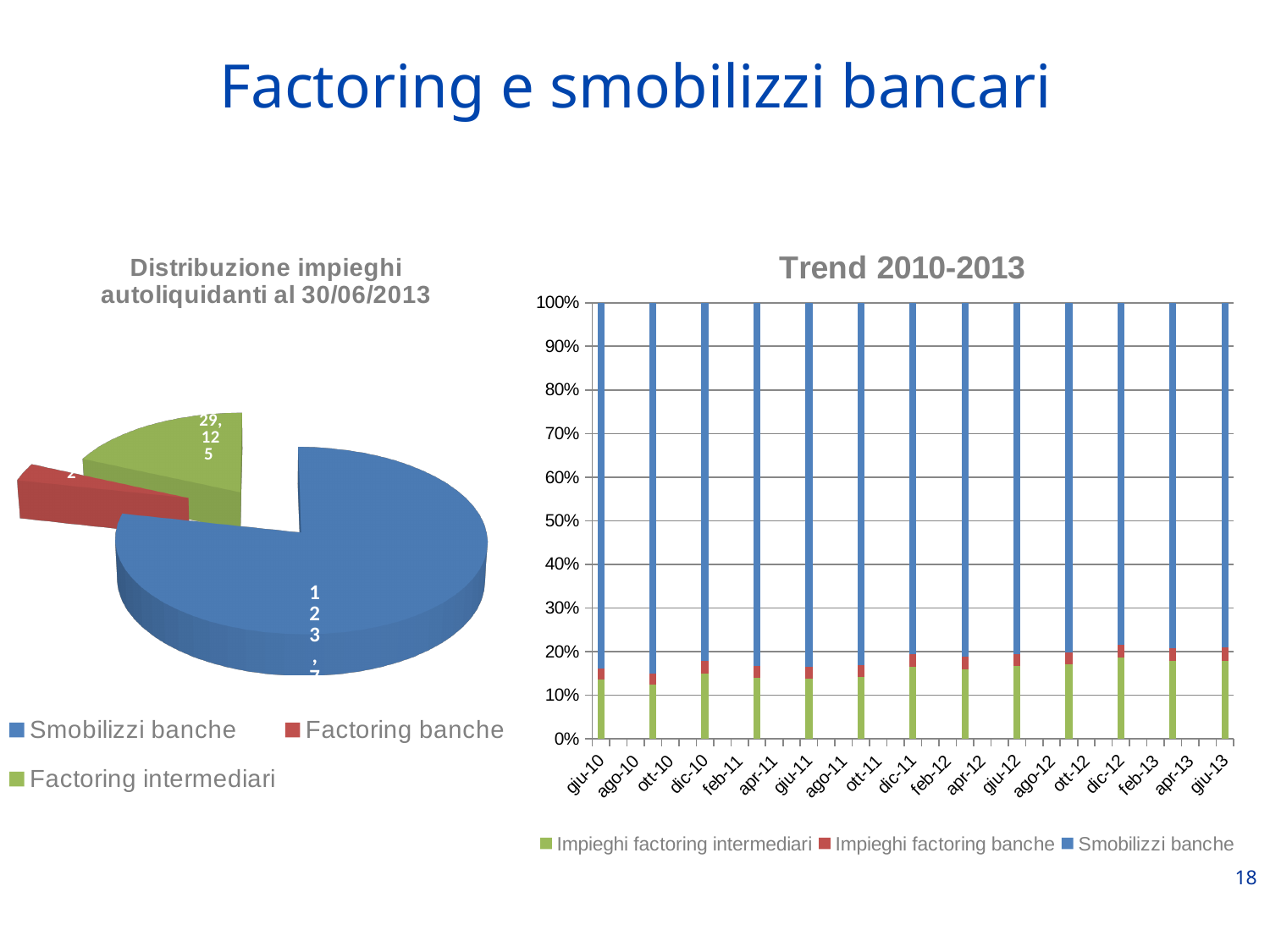
In the 'Distribuzione impieghi autoliquidanti al 30/06/2013' pie chart, which category has the smallest slice? Factoring banche What kind of chart is the 'Distribuzione impieghi autoliquidanti al 30/06/2013' chart? pie chart In the 'Trend 2010-2013' chart, what is the total height of each stacked bar? 100% In the 'Trend 2010-2013' chart, is the value for 'Impieghi factoring intermediari' in giu-10 greater or less than 20%? less How many categories does the legend of the 'Distribuzione impieghi autoliquidanti al 30/06/2013' pie chart list? 3 In the 'Trend 2010-2013' chart, does the 'Impieghi factoring intermediari' share rise or fall from giu-10 to giu-13? rise In the 'Distribuzione impieghi autoliquidanti al 30/06/2013' pie chart, which category has the largest slice? Smobilizzi banche How many series does the legend of the 'Trend 2010-2013' chart list? 3 In the 'Trend 2010-2013' chart, is the 'Smobilizzi banche' share in giu-13 greater or less than 70%? greater What kind of chart is the 'Trend 2010-2013' chart? bar chart In the 'Trend 2010-2013' chart, which series takes up the largest share of every bar? Smobilizzi banche